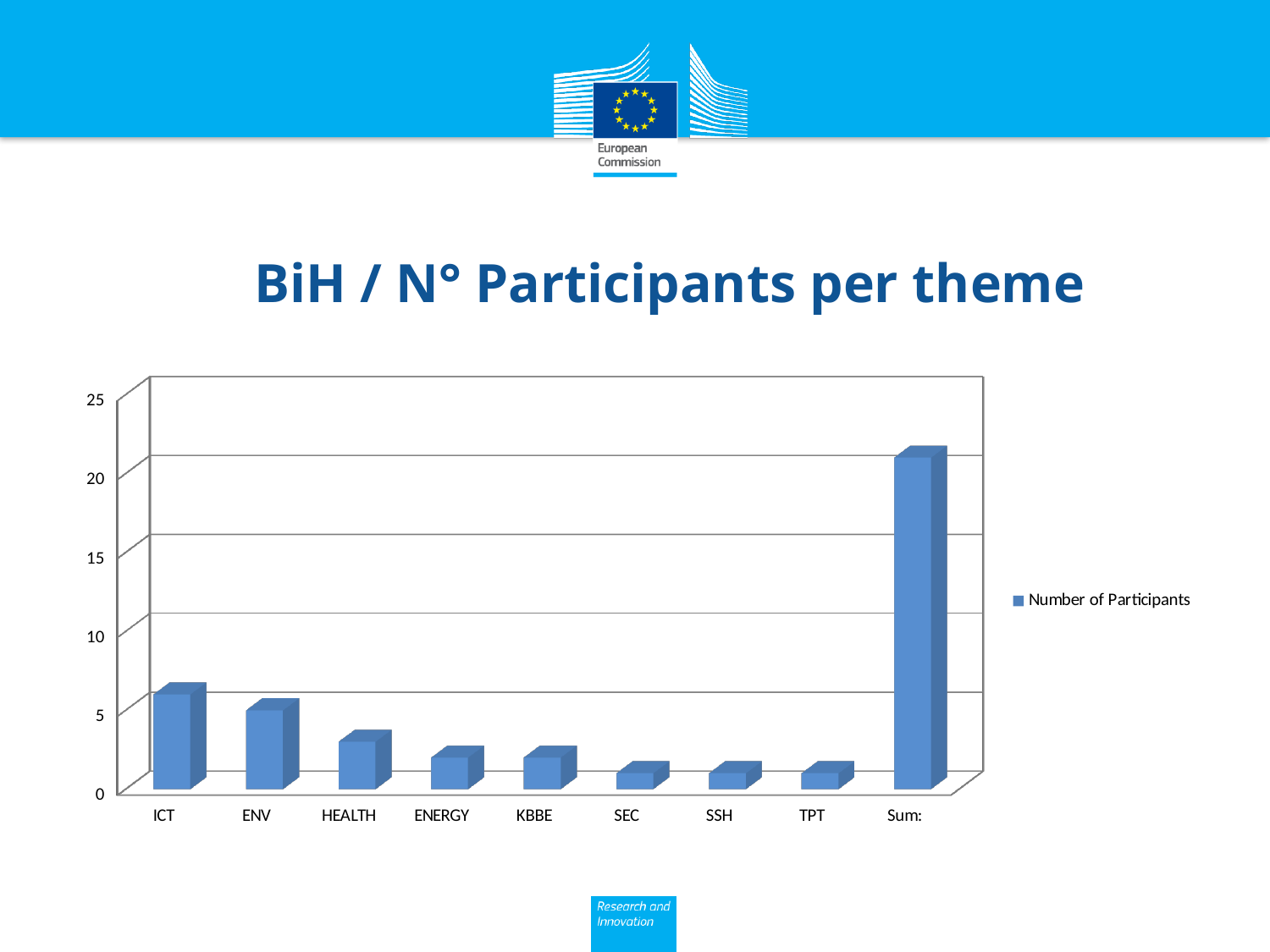
Is the value for SEC greater or less than 5? less What kind of chart is shown on the slide? bar chart Is the value for Sum: greater or less than 15? greater How many series does the legend list? 1 Is the value for HEALTH greater or less than 5? less Which has more participants, ICT or HEALTH? ICT Excluding the Sum: bar, do the values generally rise or fall from ICT to TPT along the x axis? fall What is the name of the series shown in the legend? Number of Participants What is the title of the chart on the slide? BiH / N° Participants per theme How many categories are shown on the x axis? 9 Which category has the highest bar? Sum: Among the individual themes (excluding Sum:), which theme has the highest number of participants? ICT